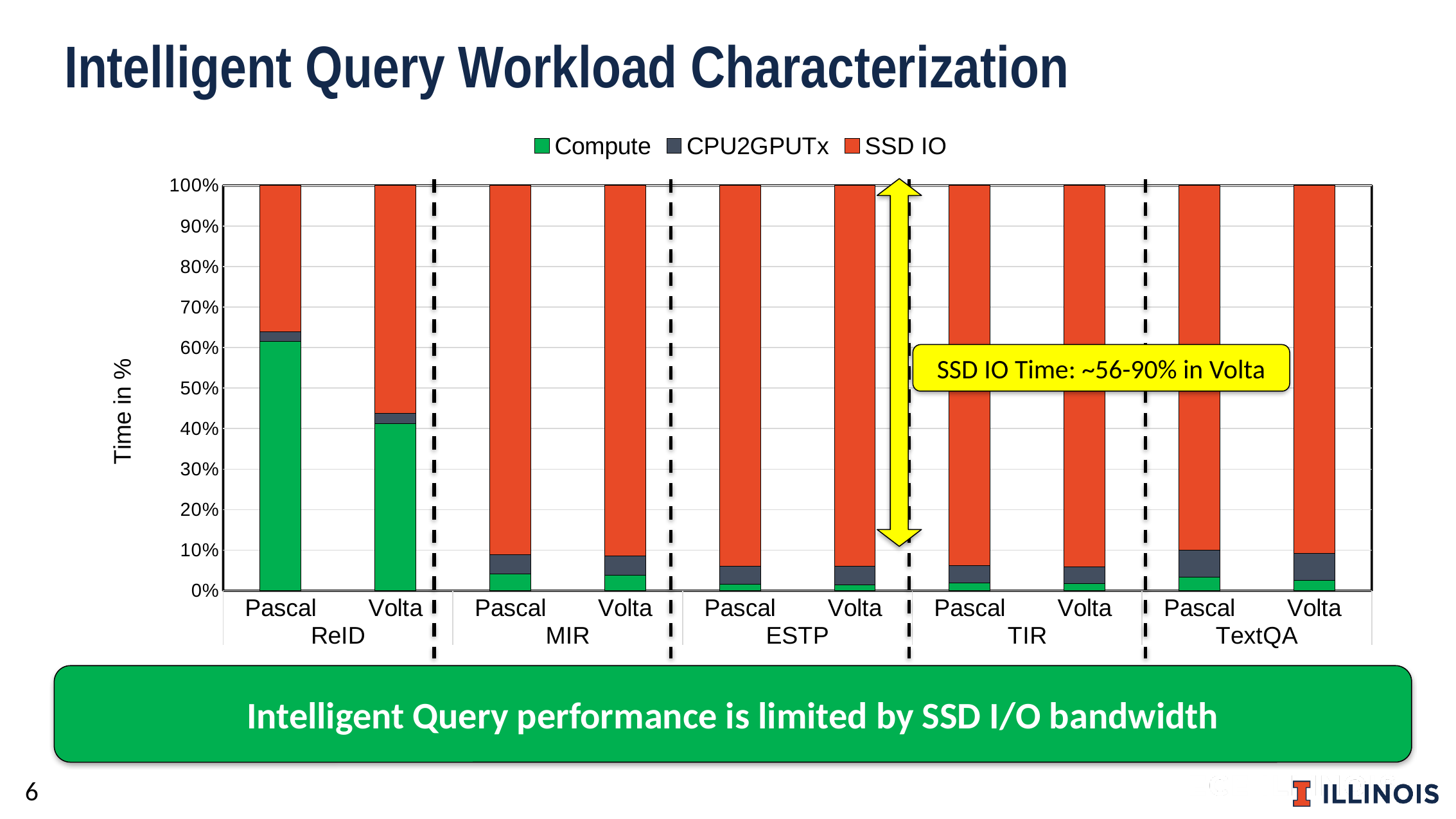
How many stacked bars are plotted in the chart? 10 Which bar has the largest Compute segment? ReID Pascal Which has the larger SSD IO share, MIR on Volta or ReID on Volta? MIR on Volta What does the yellow callout on the chart say? SSD IO Time: ~56-90% in Volta How many workloads are shown along the x axis? 5 What kind of chart is shown on the slide? Stacked bar chart How many series does the legend list? 3 Which has the larger Compute share, ReID on Pascal or ReID on Volta? ReID on Pascal Is the Compute share for MIR on Pascal greater or less than 10%? less Is the Compute share for ReID on Volta greater or less than 50%? less Which series are listed in the legend? Compute, CPU2GPUTx, SSD IO Is the Compute share for ReID on Pascal greater or less than 50%? greater